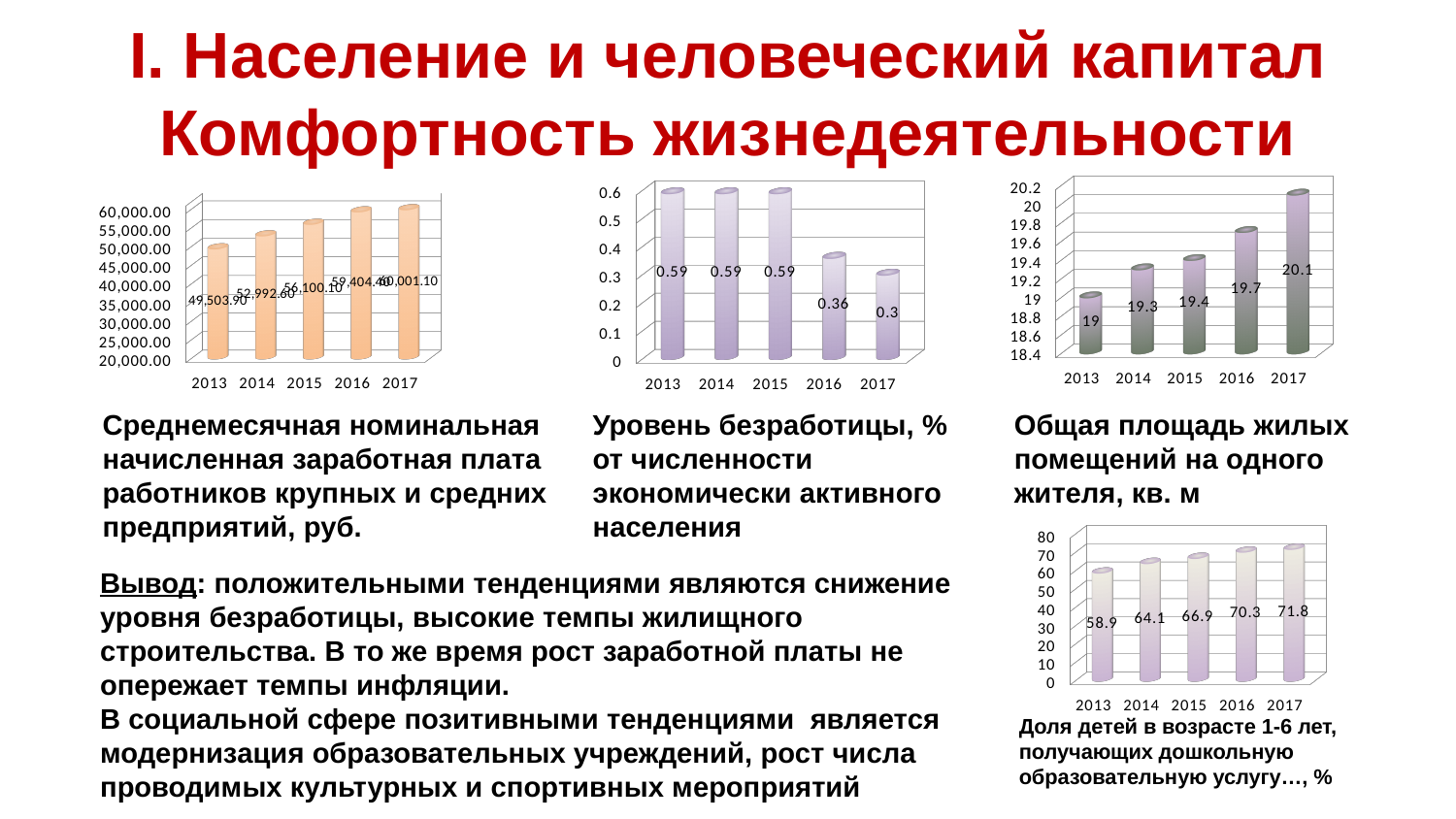
In the chart 'Общая площадь жилых помещений на одного жителя, кв. м', what is the value for 2017? 20.1 In the chart 'Доля детей в возрасте 1-6 лет, получающих дошкольную образовательную услугу…, %', what is the difference between the 2017 value and the 2013 value? 12.9 In the chart 'Уровень безработицы, % от численности экономически активного населения', what is the difference between the 2013 value and the 2017 value? 0.29 In the chart 'Общая площадь жилых помещений на одного жителя, кв. м', which year has the lowest value? 2013 How many years are shown on the x axis of the chart 'Уровень безработицы, % от численности экономически активного населения'? 5 In the chart 'Среднемесячная номинальная начисленная заработная плата работников крупных и средних предприятий, руб.', what is the value for 2013? 49,503.90 In the chart 'Уровень безработицы, % от численности экономически активного населения', what is the value for 2017? 0.3 In the chart 'Среднемесячная номинальная начисленная заработная плата работников крупных и средних предприятий, руб.', is the value for 2017 greater or less than 55,000.00? greater In the chart 'Доля детей в возрасте 1-6 лет, получающих дошкольную образовательную услугу…, %', which year has the highest value? 2017 In the chart 'Доля детей в возрасте 1-6 лет, получающих дошкольную образовательную услугу…, %', what is the value for 2014? 64.1 In the chart 'Уровень безработицы, % от численности экономически активного населения', what is the value for 2016? 0.36 In the chart 'Общая площадь жилых помещений на одного жителя, кв. м', do the values rise or fall from 2013 to 2017? rise